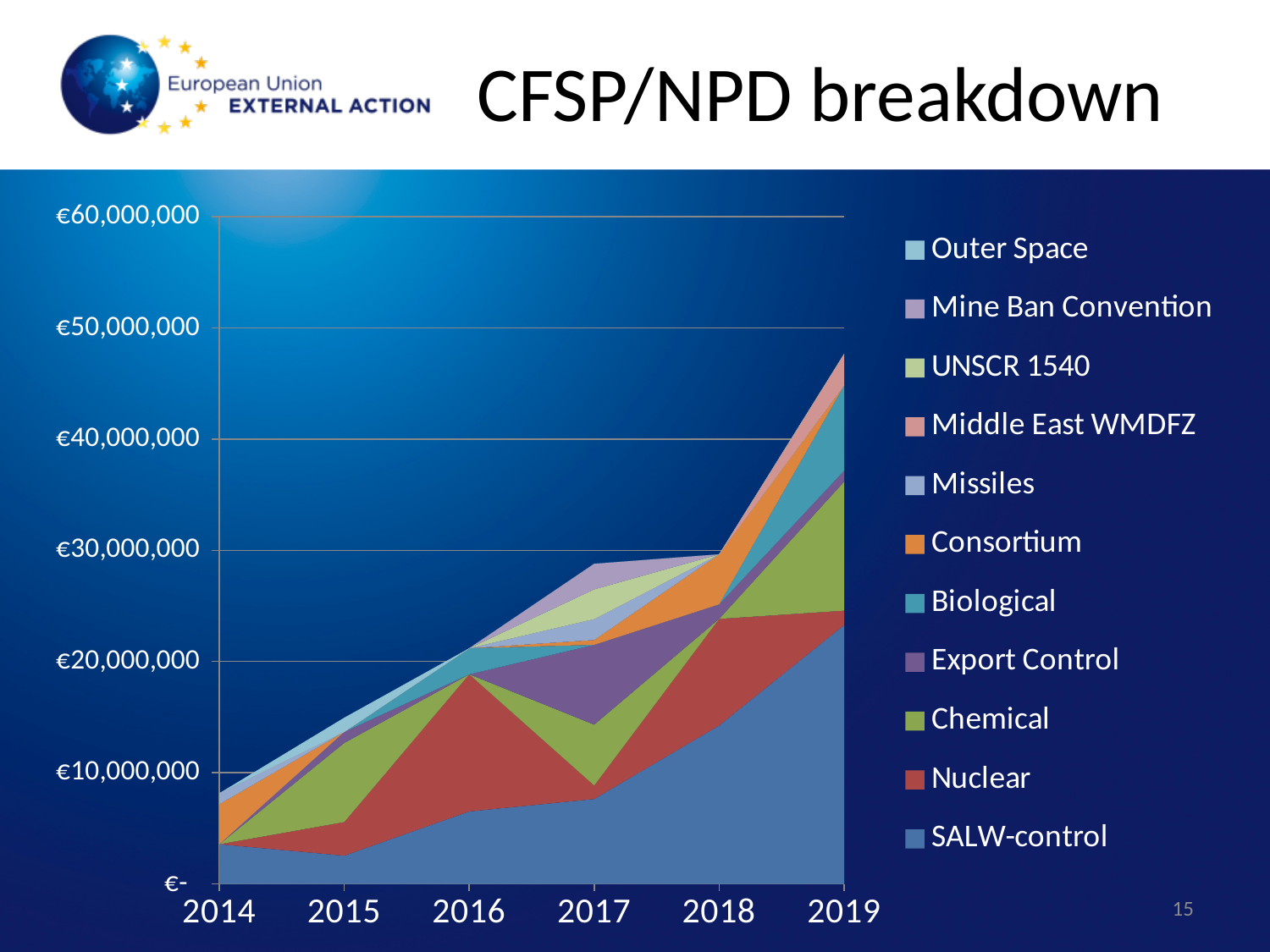
Which year has the lowest total value? 2014 Is the total value for 2015 greater or less than €10,000,000? greater Is the total value for 2019 greater or less than €40,000,000? greater Which is larger, the total value for 2019 or the total value for 2014? 2019 How many years are shown along the x axis? 6 What is the title of the chart? CFSP/NPD breakdown Which series is listed last (at the bottom) in the legend? SALW-control Which year has the highest total value? 2019 Is the total value for 2014 greater or less than €10,000,000? less Does the total value rise or fall from 2014 to 2019? Rise What kind of chart is shown on the slide? Stacked area chart How many series does the legend list? 11